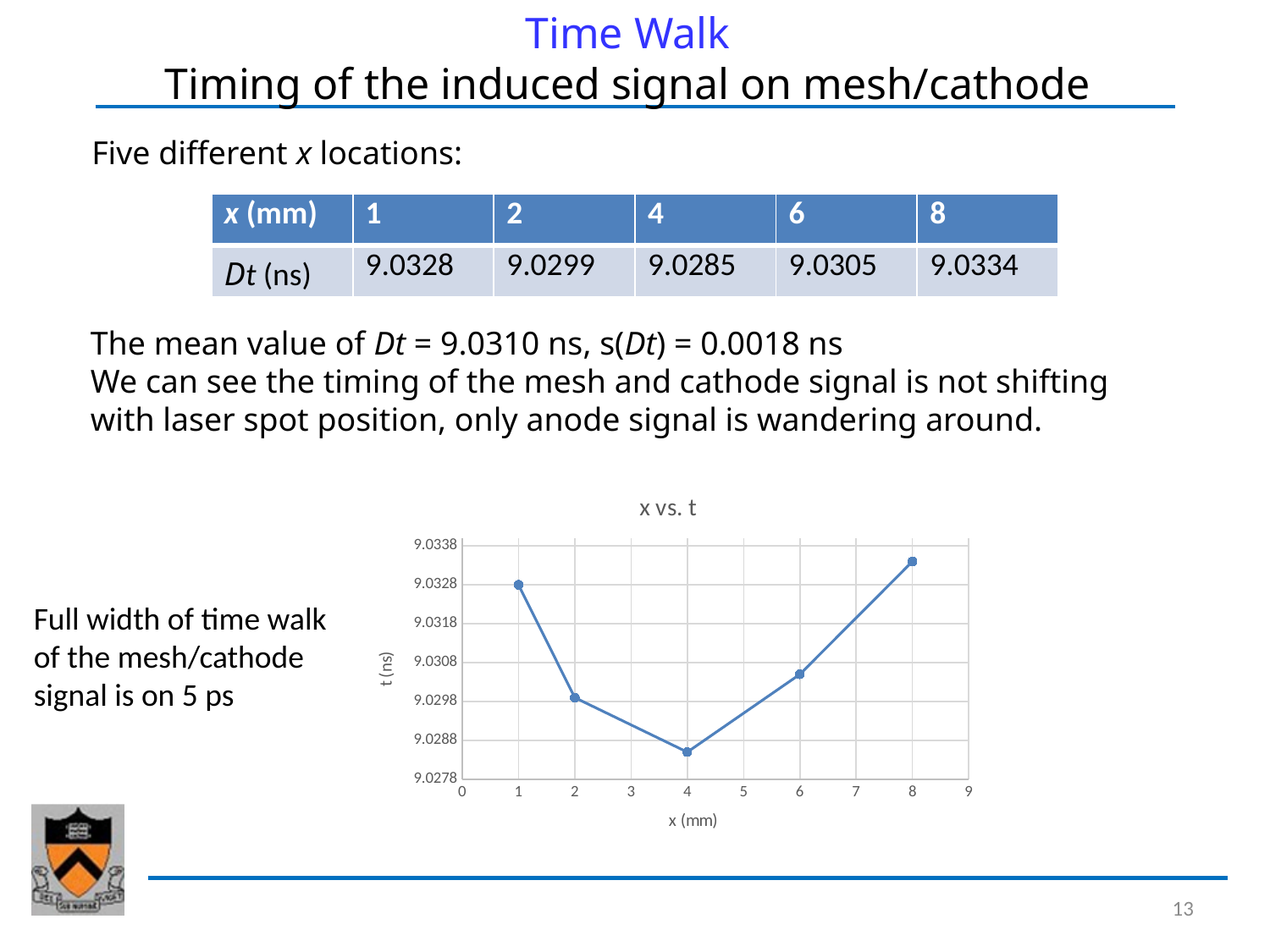
At which x (mm) value is t lowest in the x vs. t chart? 4 What kind of chart is shown on the slide? line chart Is the value of t at x = 8 mm greater or less than 9.0328? greater What is the difference between the t values at x = 8 mm and x = 4 mm? 0.0049 ns At which x (mm) value is t highest in the x vs. t chart? 8 What is the value of t (ns) at x = 1 mm in the x vs. t chart? 9.0328 How many data points are plotted in the x vs. t chart? 5 Which has the larger t value in the x vs. t chart: x = 2 mm or x = 6 mm? x = 6 mm How does t change as x increases from 1 to 8 mm in the x vs. t chart? falls then rises Is the value of t at x = 4 mm greater or less than 9.0288? less What is the value of t (ns) at x = 8 mm in the x vs. t chart? 9.0334 Is the value of t at x = 6 mm greater or less than 9.0298? greater